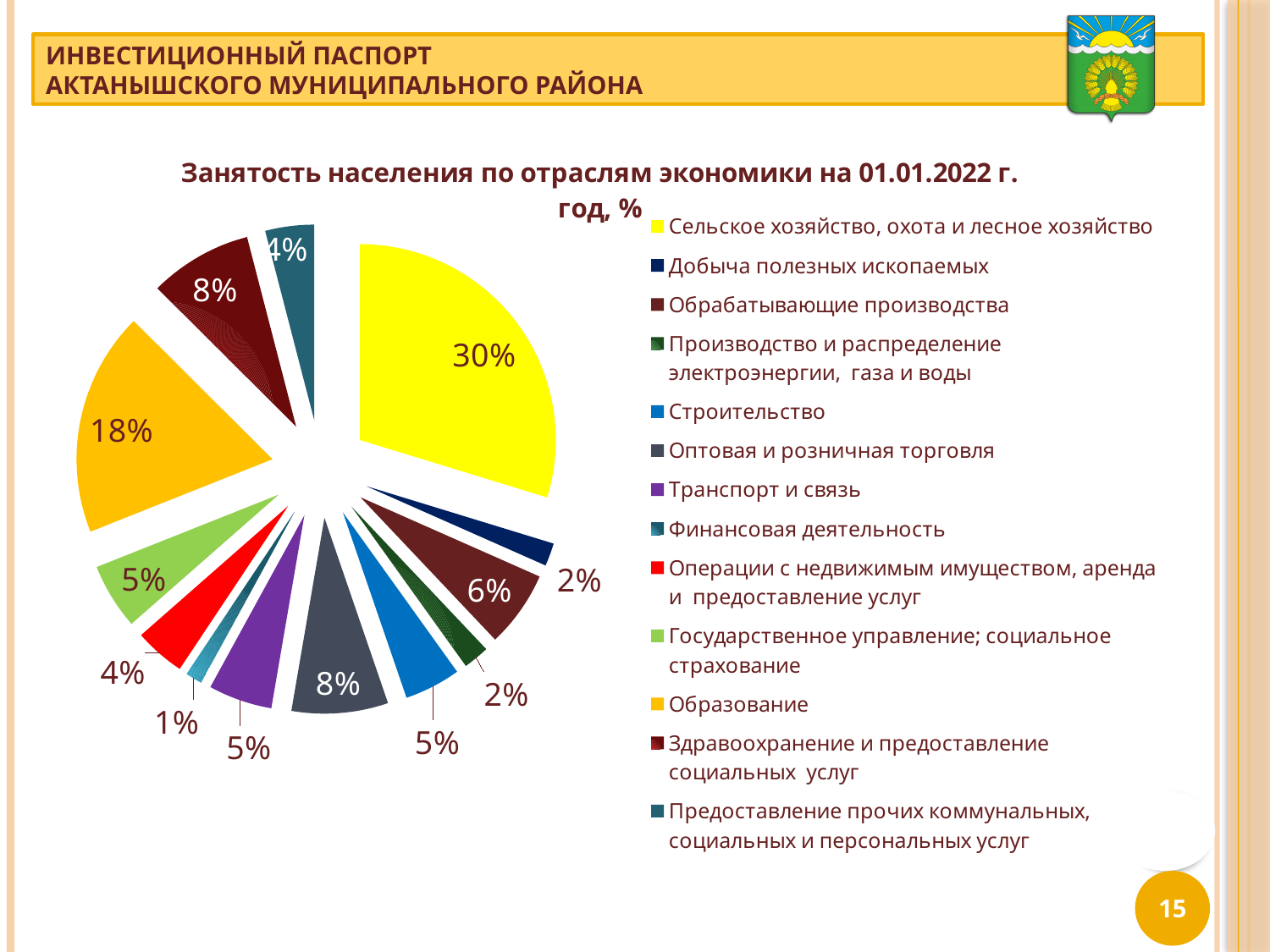
What share of employment does "Оптовая и розничная торговля" have? 8% Which has a larger share: "Образование" or "Обрабатывающие производства"? Образование What share of employment does "Финансовая деятельность" have? 1% What share of employment does "Обрабатывающие производства" have? 6% By how many percentage points does the share of "Сельское хозяйство, охота и лесное хозяйство" exceed that of "Образование"? 12 percentage points Which sector has the smallest share of employment? Финансовая деятельность What kind of chart is shown on the slide? Pie chart What share of employment does "Сельское хозяйство, охота и лесное хозяйство" have? 30% Which sector has the largest share of employment? Сельское хозяйство, охота и лесное хозяйство What colour is the slice for "Сельское хозяйство, охота и лесное хозяйство"? Yellow What share of employment does "Образование" have? 18% How many sectors are listed in the chart legend? 13